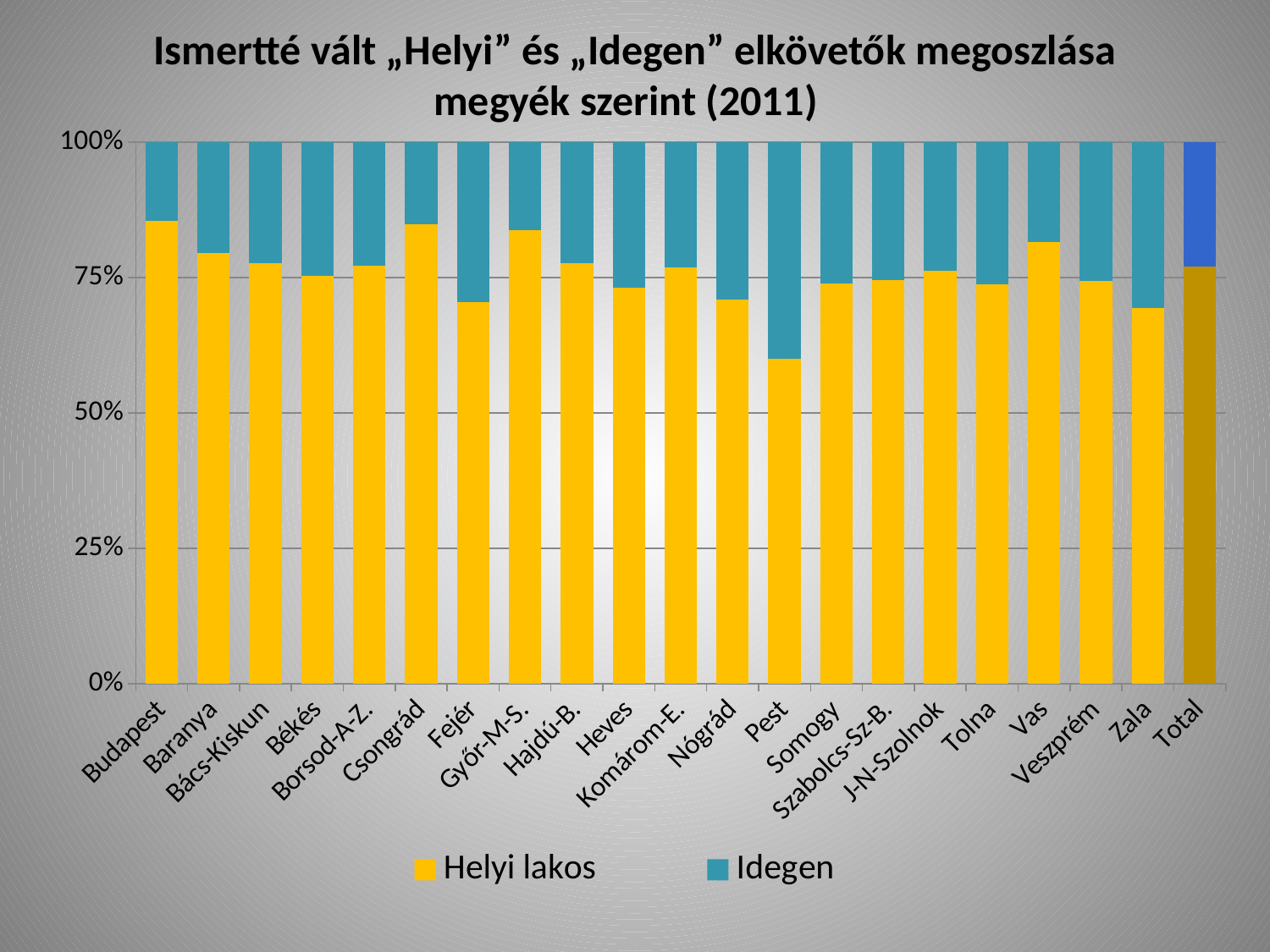
Is the Helyi lakos share for Budapest greater or less than 75%? greater Is the Helyi lakos share for Pest greater or less than 75%? less How many series does the legend list? 2 Is the Helyi lakos share for Zala greater or less than 75%? less What kind of chart is shown on the slide? Stacked bar chart What do the Helyi lakos and Idegen segments of the Budapest bar add up to? 100% Which category has the lowest share of Helyi lakos? Pest What are the two series named in the legend? Helyi lakos and Idegen Which category has the highest share of Idegen? Pest How many categories are shown along the x axis, including Total? 21 Which has the larger Helyi lakos share, Budapest or Pest? Budapest